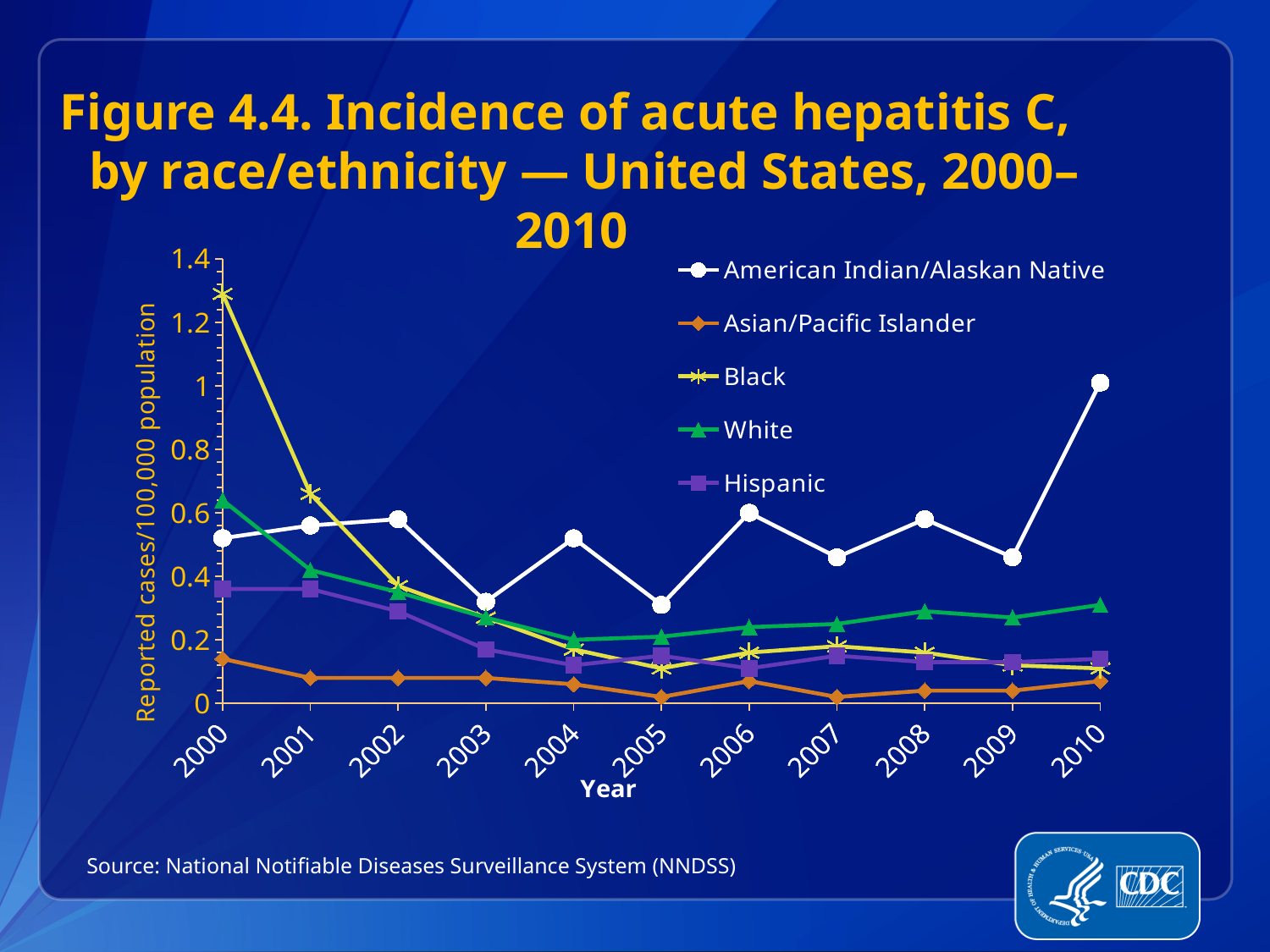
How many series does the legend list? 5 How many years are plotted along the x axis? 11 Is the value for Black in 2000 greater or less than 1? greater Does the Black series rise or fall from 2000 to 2005? Fall What is the label on the y axis? Reported cases/100,000 population Which race/ethnicity group had the highest incidence in 2000? Black In 2010, which is larger: the value for White or the value for Hispanic? White What kind of chart is shown on the slide? Line chart Which race/ethnicity group had the lowest incidence in 2005? Asian/Pacific Islander Is the value for American Indian/Alaskan Native in 2010 greater or less than 0.8? greater Which race/ethnicity group had the highest incidence in 2010? American Indian/Alaskan Native Is the value for Asian/Pacific Islander in 2005 greater or less than 0.2? less